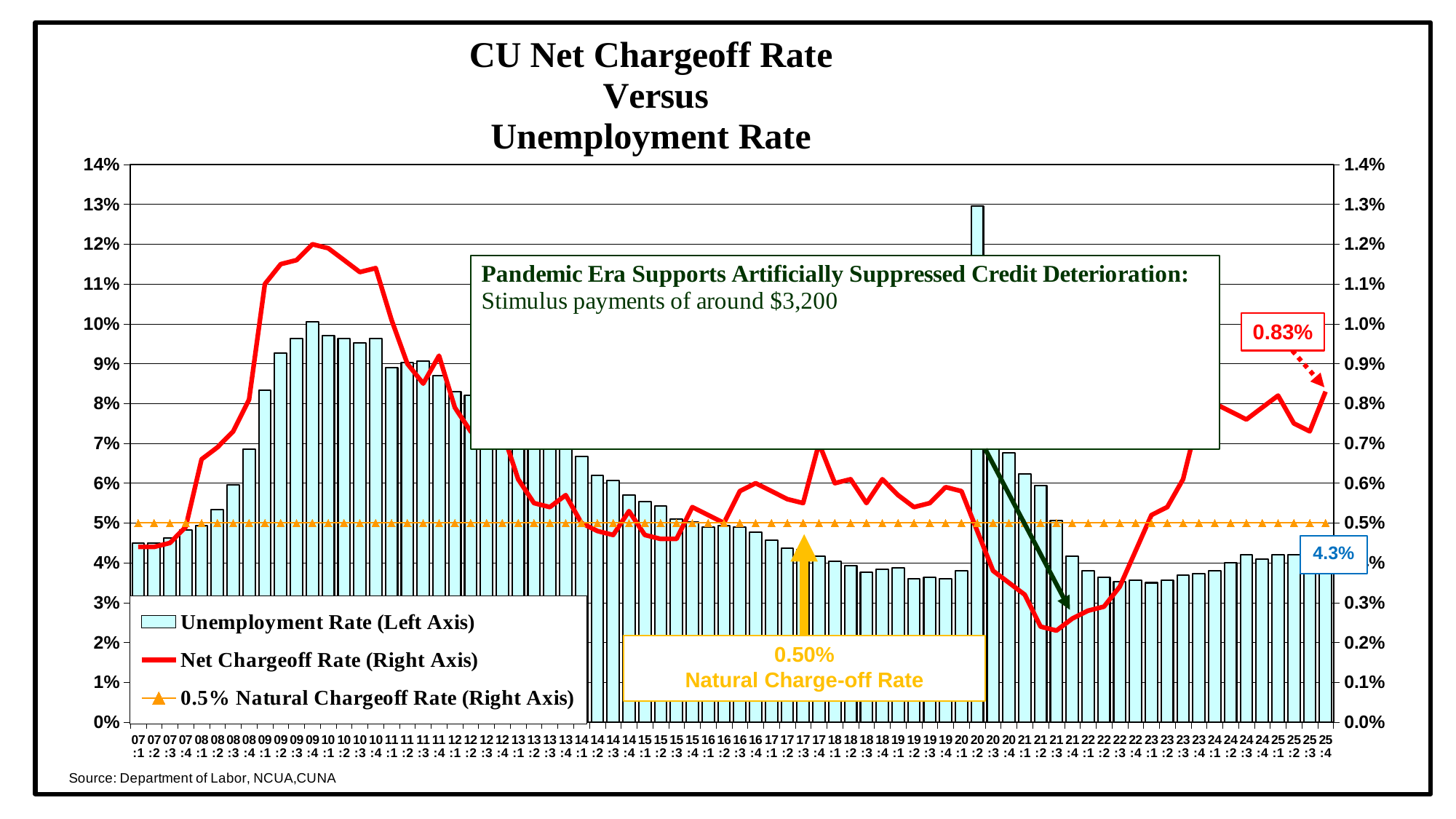
What is the Unemployment Rate labelled at the last quarter (25:4)? 4.3% What is the title of the chart? CU Net Chargeoff Rate Versus Unemployment Rate Is the Unemployment Rate for 20:2 greater or less than 12%? greater What kind of chart is shown on the slide? A combined bar and line chart By how much does the Net Chargeoff Rate at 25:4 (0.83%) exceed the 0.50% Natural Charge-off Rate? 0.33% Which quarter has the highest Unemployment Rate bar? 20:2 What value is given for the Natural Charge-off Rate? 0.50% Is the Net Chargeoff Rate for 21:2 greater or less than 0.3%? less What is the Net Chargeoff Rate labelled at the last quarter (25:4)? 0.83% Does the Net Chargeoff Rate rise or fall from 21:2 to 23:4? rise Which is larger at 25:4: the Net Chargeoff Rate or the 0.5% Natural Chargeoff Rate? Net Chargeoff Rate How many series does the legend list? 3